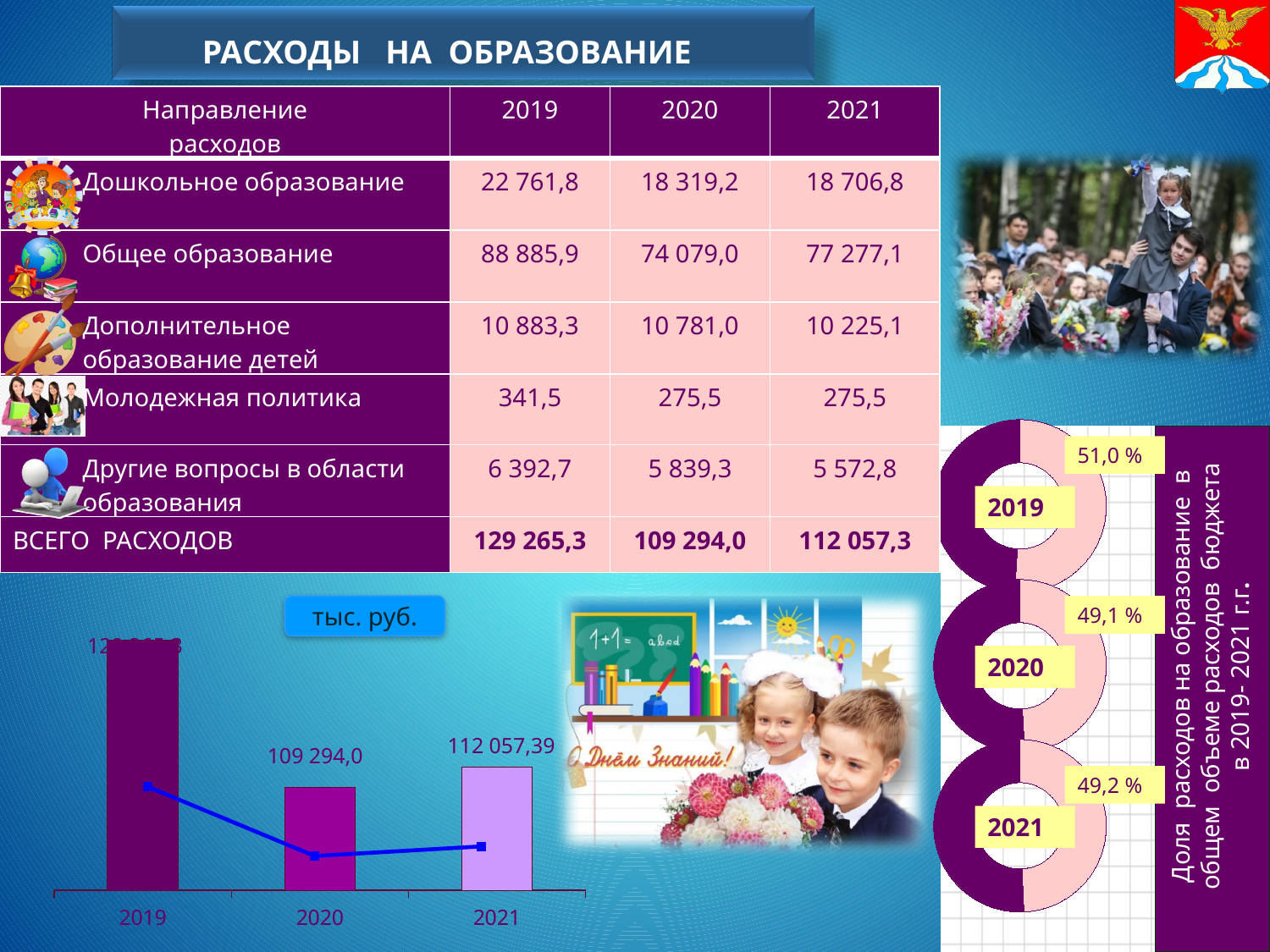
What kind of chart is shown at the bottom left of the slide? bar chart In the bar chart at the bottom left, which year has the shortest bar? 2020 What unit label is shown above the bar chart at the bottom left? тыс. руб. In the ring charts on the right, what share is shown for 2020? 49,1 % In the bar chart at the bottom left, what is the difference between the 2021 value and the 2020 value? 2 763,39 In the ring charts on the right, what share is shown for 2019? 51,0 % In the bar chart at the bottom left, what is the value shown for 2020? 109 294,0 In the bar chart at the bottom left, which bar is taller, 2020 or 2021? 2021 In the bar chart at the bottom left, what is the value shown for 2021? 112 057,39 In the bar chart at the bottom left, which year has the tallest bar? 2019 In the ring charts on the right, which year has the highest share? 2019 How many bars are shown in the bar chart at the bottom left? 3